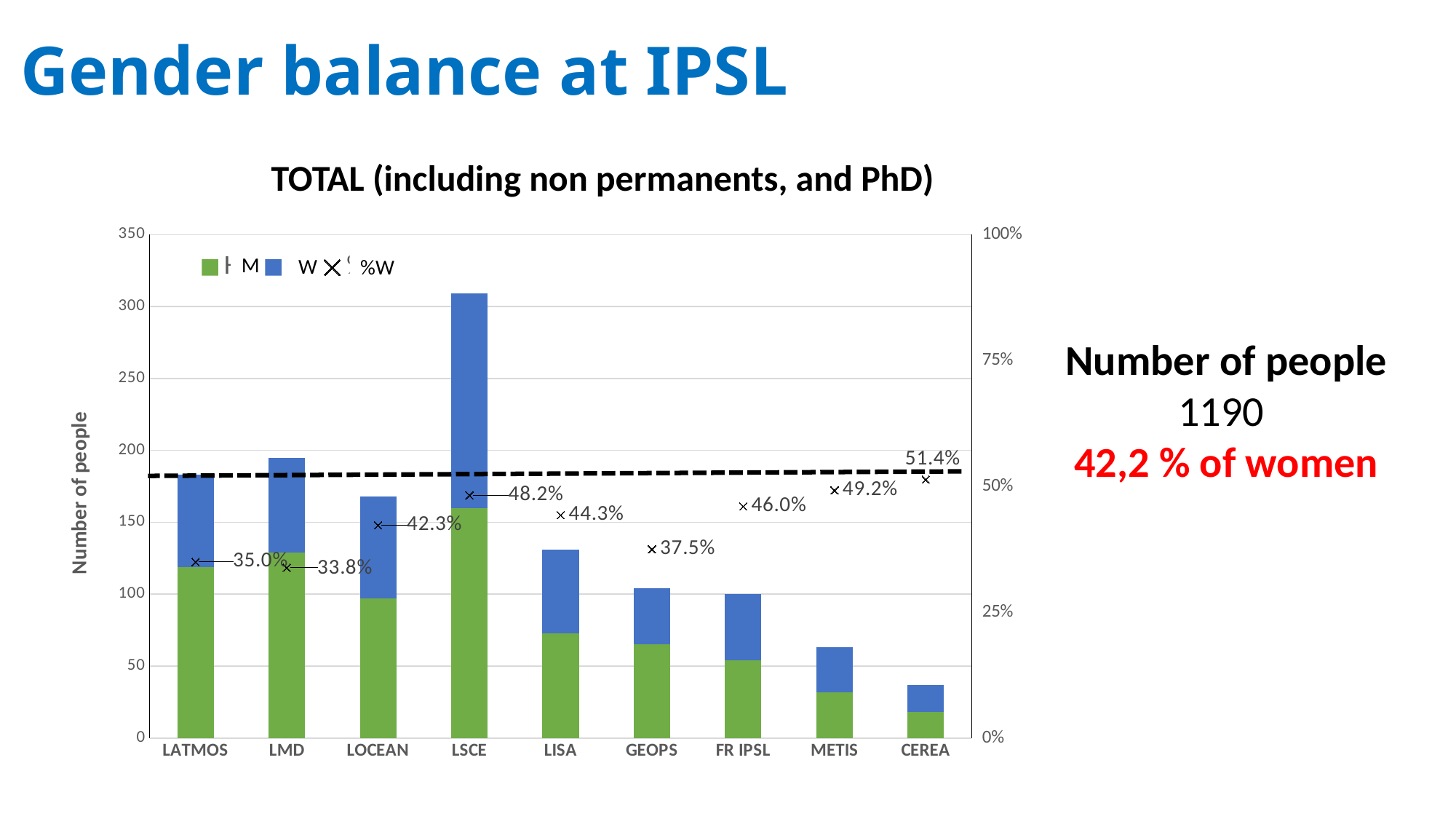
How many series does the legend list? 3 Is the total number of people for LSCE greater or less than 300? greater What is the %W value for GEOPS? 37.5% Is the total number of people for CEREA greater or less than 50? less What is the %W value for CEREA? 51.4% What is the %W value for LSCE? 48.2% Which laboratory has the lowest %W value? LMD What is the difference between the %W values of CEREA and LMD? 17.6% Which has a higher %W value, LSCE or LISA? LSCE How many laboratories are shown on the x axis? 9 Which laboratory has the tallest stacked bar (largest number of people)? LSCE Which laboratory has the highest %W value? CEREA